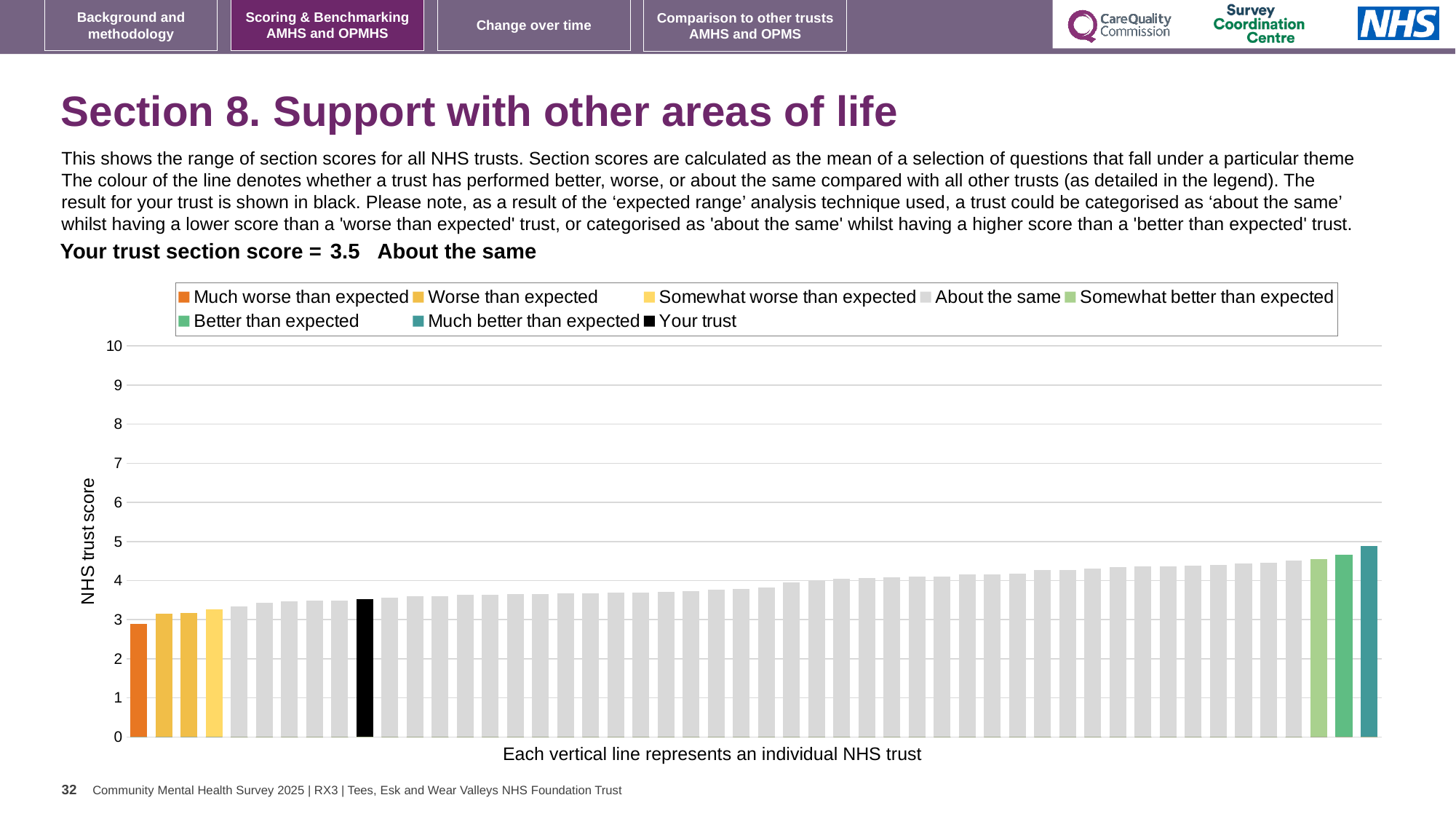
Which category is your trust placed in for this section? About the same What is the title of the vertical axis? NHS trust score What kind of chart is shown on the slide? bar chart Is the value of the black 'Your trust' bar greater or less than 4? less Is the value of the tallest bar in the chart greater or less than 6? less Do the bar values rise or fall from left to right along the x axis? rise Is the value of the black 'Your trust' bar greater or less than 3? greater What is the section score for your trust? 3.5 Which legend category does the tallest bar belong to? Much better than expected How many entries does the chart legend list? 8 Which legend category does the shortest bar belong to? Much worse than expected